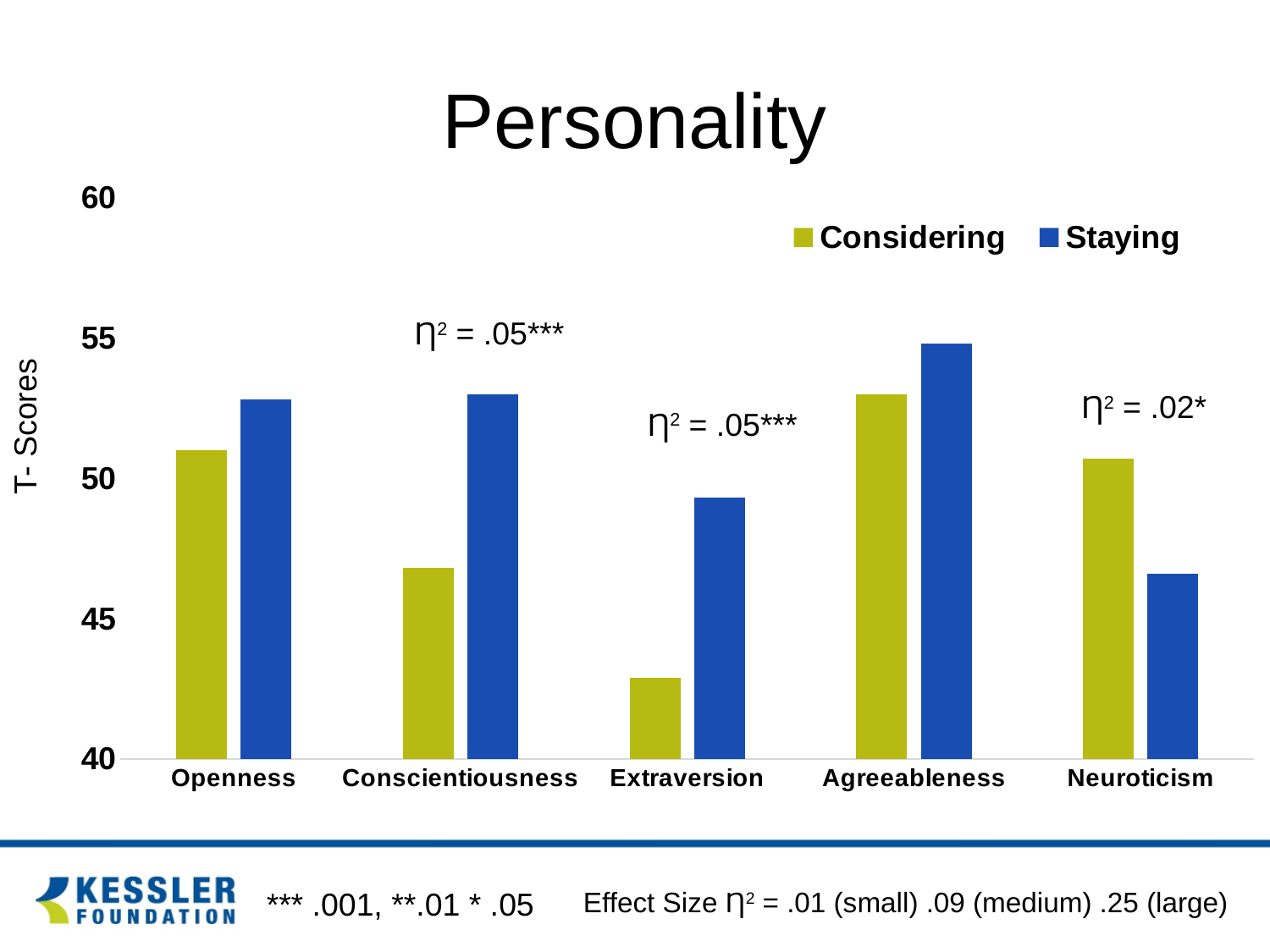
For Neuroticism, which is larger: the Considering value or the Staying value? Considering What effect size is annotated above the Neuroticism bars? η² = .02* Is the Staying value for Openness greater or less than 50? greater Which personality trait has the lowest Considering value? Extraversion Is the Considering value for Extraversion greater or less than 45? less For Extraversion, which is larger: the Considering value or the Staying value? Staying Is the Considering value for Conscientiousness greater or less than 50? less How many personality traits are shown on the x axis? 5 Which personality trait has the highest Staying value? Agreeableness Which personality trait has the lowest Staying value? Neuroticism What kind of chart is shown on the slide? bar chart How many series does the legend list? 2